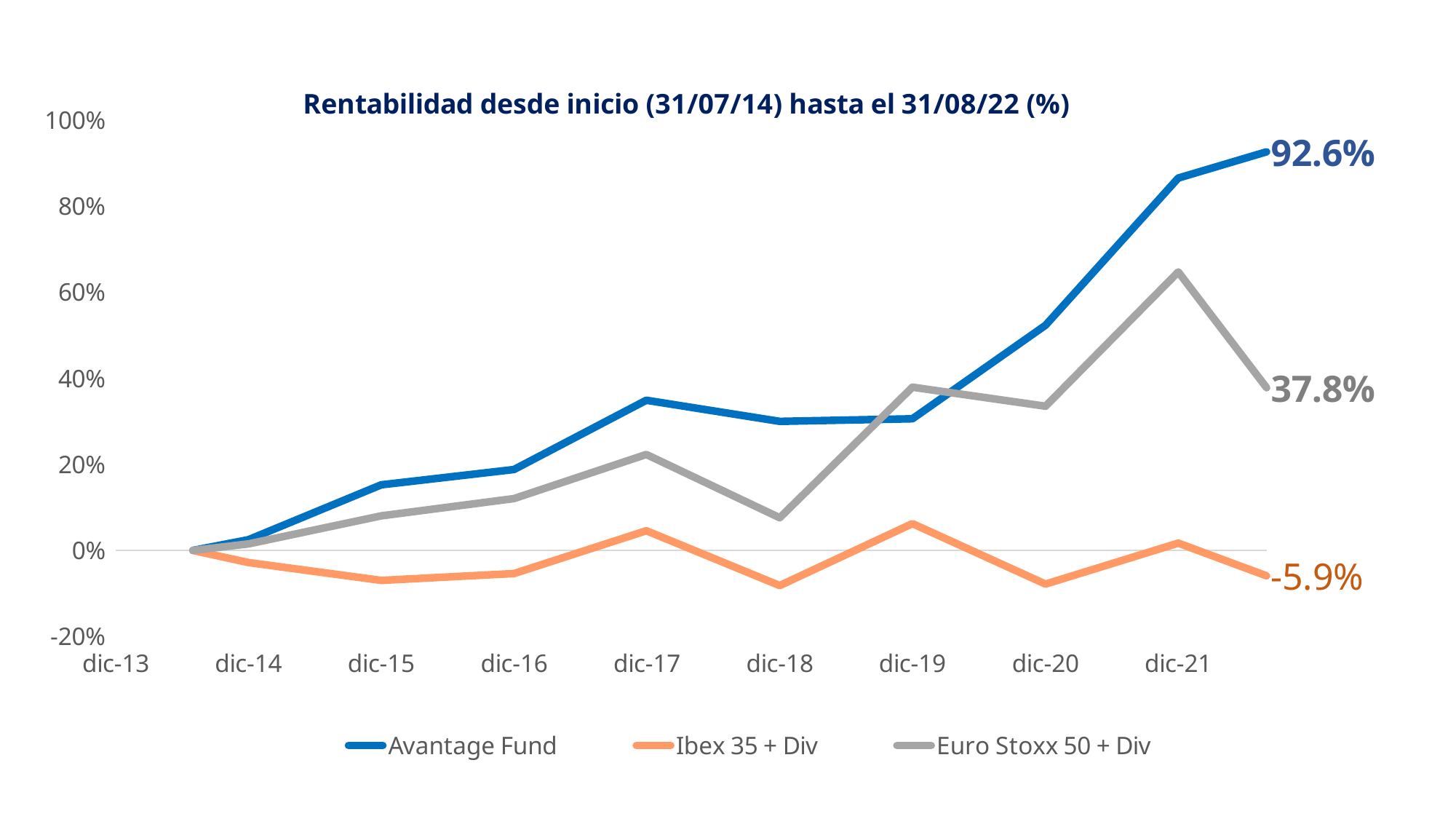
Is the value for Avantage Fund at dic-21 greater or less than 80%? greater Is the value for Ibex 35 + Div at dic-18 greater or less than 0%? less What is the difference between the final values of Avantage Fund and Euro Stoxx 50 + Div? 54.8 percentage points Does the Avantage Fund line generally rise or fall from dic-14 to the end of the period? Rise How many series does the legend list? 3 Which series has the highest value at the end of the period? Avantage Fund What kind of chart is shown on the slide? Line chart Which is larger at the end of the period, Euro Stoxx 50 + Div or Ibex 35 + Div? Euro Stoxx 50 + Div What is the final value shown for Ibex 35 + Div? -5.9% Which series has the lowest value at the end of the period? Ibex 35 + Div What is the final value shown for Avantage Fund at the end of the line? 92.6% What is the final value shown for Euro Stoxx 50 + Div? 37.8%